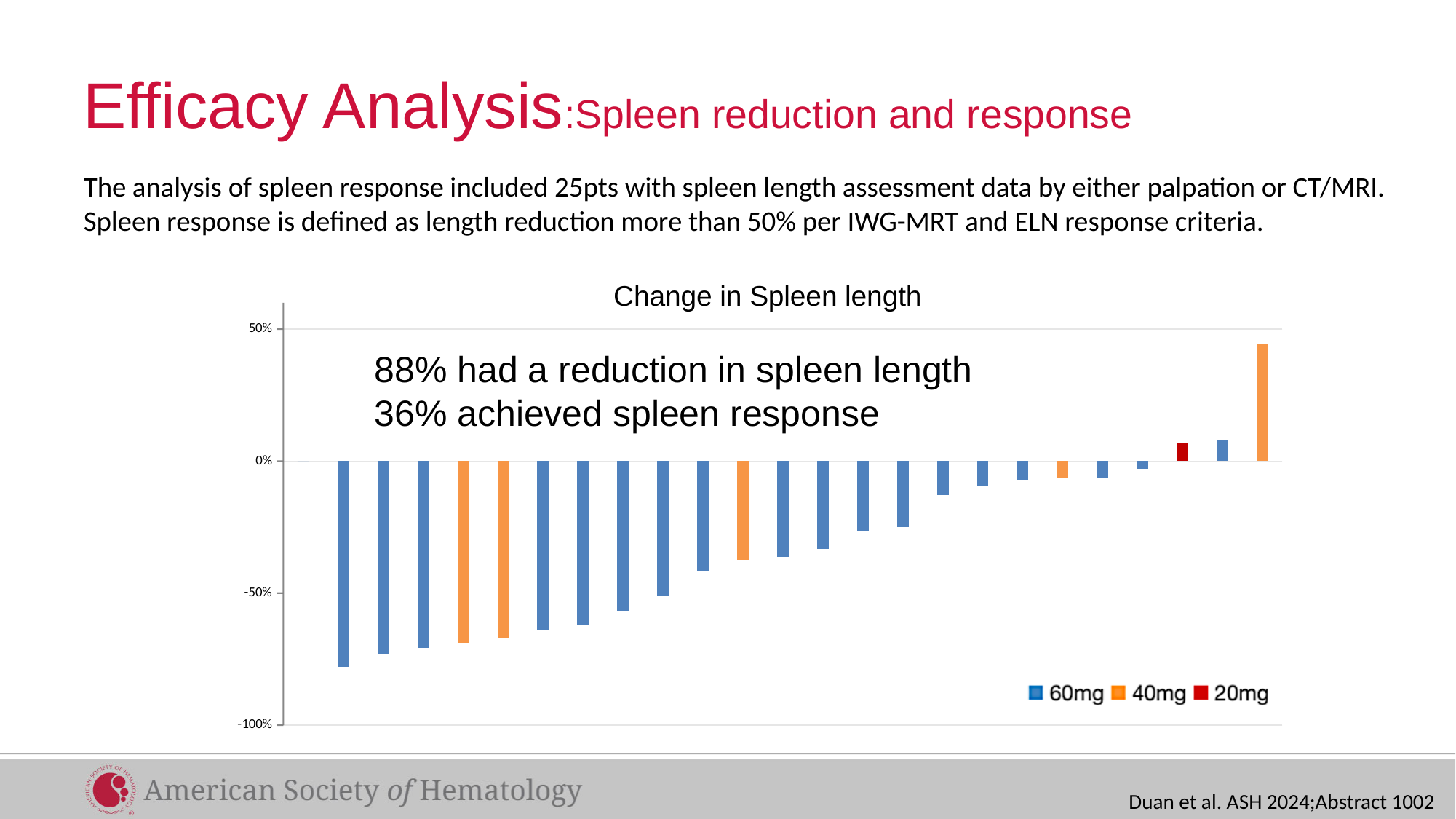
Which is larger, the value of the leftmost bar or the value of the rightmost bar? the rightmost bar Do the bar values rise or fall from left to right along the x axis? rise Which dose group does the lowest bar in the chart belong to? 60mg How many series does the legend of the 'Change in Spleen length' chart list? 3 According to the annotation on the chart, what percentage achieved spleen response? 36% Is the value for the red 20mg bar greater or less than 0%? greater What are the three entries in the legend of the chart? 60mg, 40mg, 20mg Is the value for the rightmost bar greater or less than 50%? less What kind of chart is shown on the slide? bar chart How many bars in the chart belong to the 20mg group? 1 Is the value for the leftmost bar greater or less than -50%? less Which dose group does the highest bar in the chart belong to? 40mg